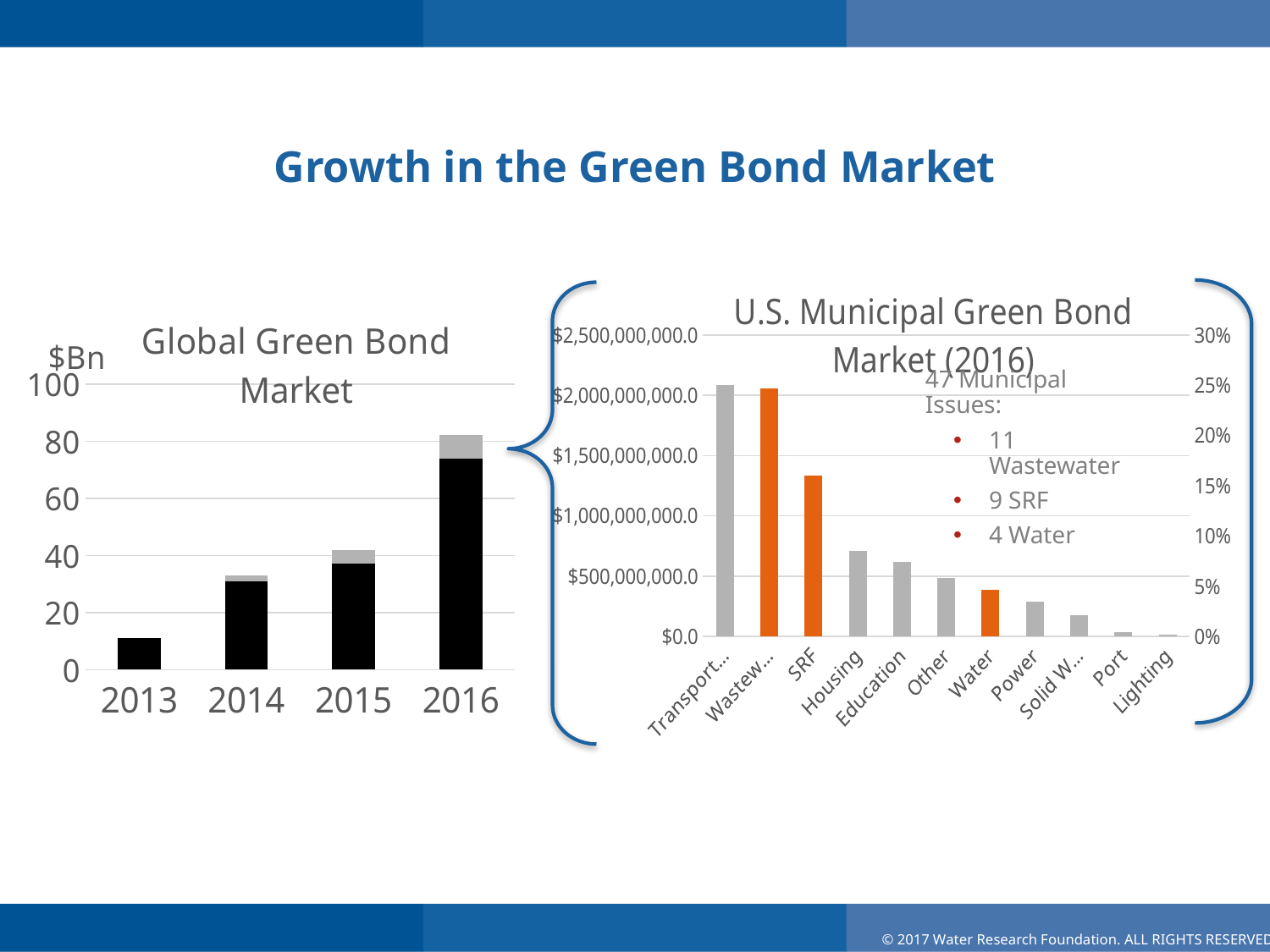
On the U.S. Municipal Green Bond Market (2016) chart, how many categories are shown on the x axis? 11 On the Global Green Bond Market chart, what kind of chart is shown? bar chart On the Global Green Bond Market chart, which year has the lowest value? 2013 On the Global Green Bond Market chart, is the value for 2013 greater or less than 20? less On the U.S. Municipal Green Bond Market (2016) chart, is the value for SRF greater or less than $1,000,000,000.0? greater On the Global Green Bond Market chart, do the values rise or fall from 2013 to 2016? rise On the Global Green Bond Market chart, is the total value for 2016 greater or less than 60? greater On the U.S. Municipal Green Bond Market (2016) chart, which category has the lowest value? Lighting On the U.S. Municipal Green Bond Market (2016) chart, which is larger, the value for SRF or the value for Housing? SRF On the Global Green Bond Market chart, which year has the highest value? 2016 On the Global Green Bond Market chart, how many years are shown on the x axis? 4